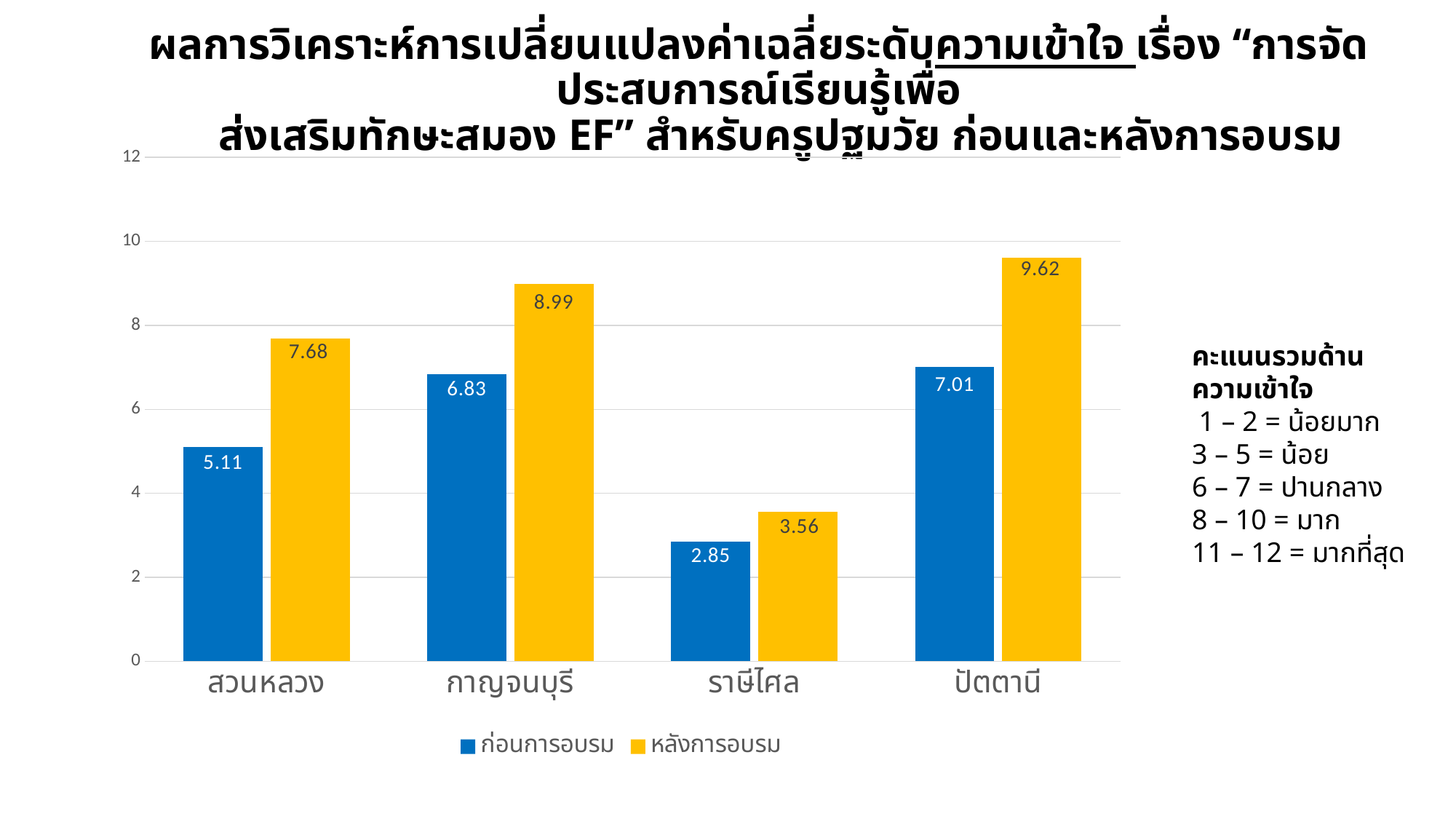
What is the หลังการอบรม value for ราษีไศล? 3.56 Is the หลังการอบรม value for ปัตตานี greater or less than 10? less What is the ก่อนการอบรม value for สวนหลวง? 5.11 What kind of chart is shown on the slide? bar chart What is the ก่อนการอบรม value for ปัตตานี? 7.01 How many categories are shown on the x axis? 4 How many series does the legend list? 2 What is the หลังการอบรม value for กาญจนบุรี? 8.99 Which is larger: the ก่อนการอบรม value for กาญจนบุรี or the ก่อนการอบรม value for ปัตตานี? ปัตตานี Which category has the lowest ก่อนการอบรม value? ราษีไศล Which category has the highest หลังการอบรม value? ปัตตานี What is the difference between the หลังการอบรม and ก่อนการอบรม values for สวนหลวง? 2.57